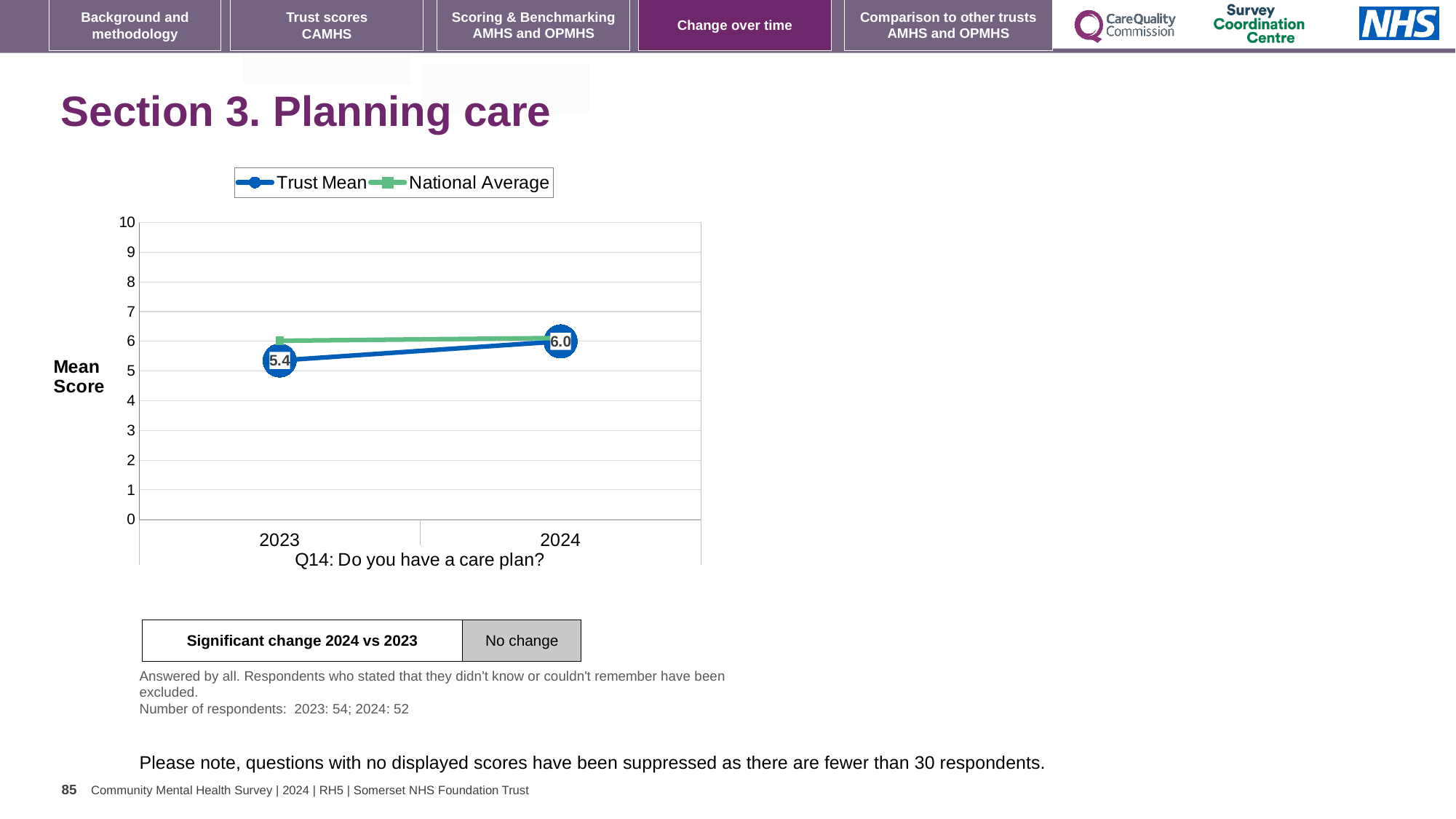
Does the Trust Mean rise or fall from 2023 to 2024? Rise How many years are plotted on the x axis? 2 Is the National Average value for 2024 greater or less than 7? less By how much did the Trust Mean score change from 2023 to 2024? 0.6 Is the National Average value for 2023 greater or less than 5? greater What is the Trust Mean score for 2023? 5.4 In 2023, which is higher: the Trust Mean or the National Average? National Average How many series does the legend list? 2 What kind of chart is shown on the slide? Line chart In which year is the Trust Mean score highest? 2024 What is the Trust Mean score for 2024? 6.0 In which year is the Trust Mean score lowest? 2023